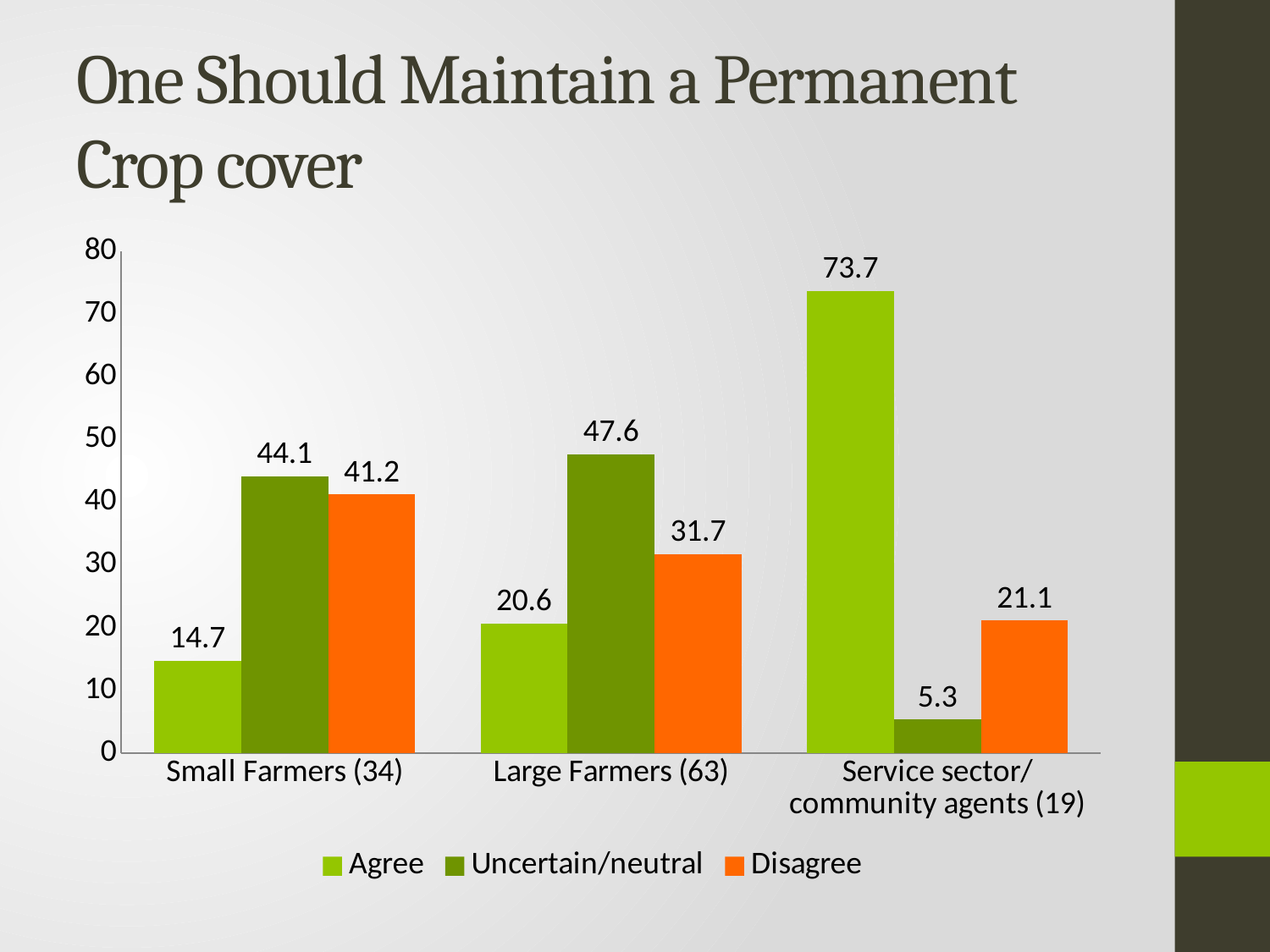
What kind of chart is shown on the slide? Bar chart What is the Agree value for Small Farmers (34)? 14.7 What is the difference between the Agree values for Service sector/community agents (19) and Small Farmers (34)? 59 What is the Uncertain/neutral value for Large Farmers (63)? 47.6 Which category has the lowest Uncertain/neutral value? Service sector/community agents (19) Which category has the highest Agree value? Service sector/community agents (19) What is the Disagree value for Service sector/community agents (19)? 21.1 How many series does the legend list? 3 Which is larger for Large Farmers (63): the Uncertain/neutral value or the Disagree value? Uncertain/neutral How many categories are shown on the x axis? 3 Do the Agree values rise or fall from Small Farmers (34) to Service sector/community agents (19)? Rise Is the Disagree value for Small Farmers (34) greater or less than 40? greater